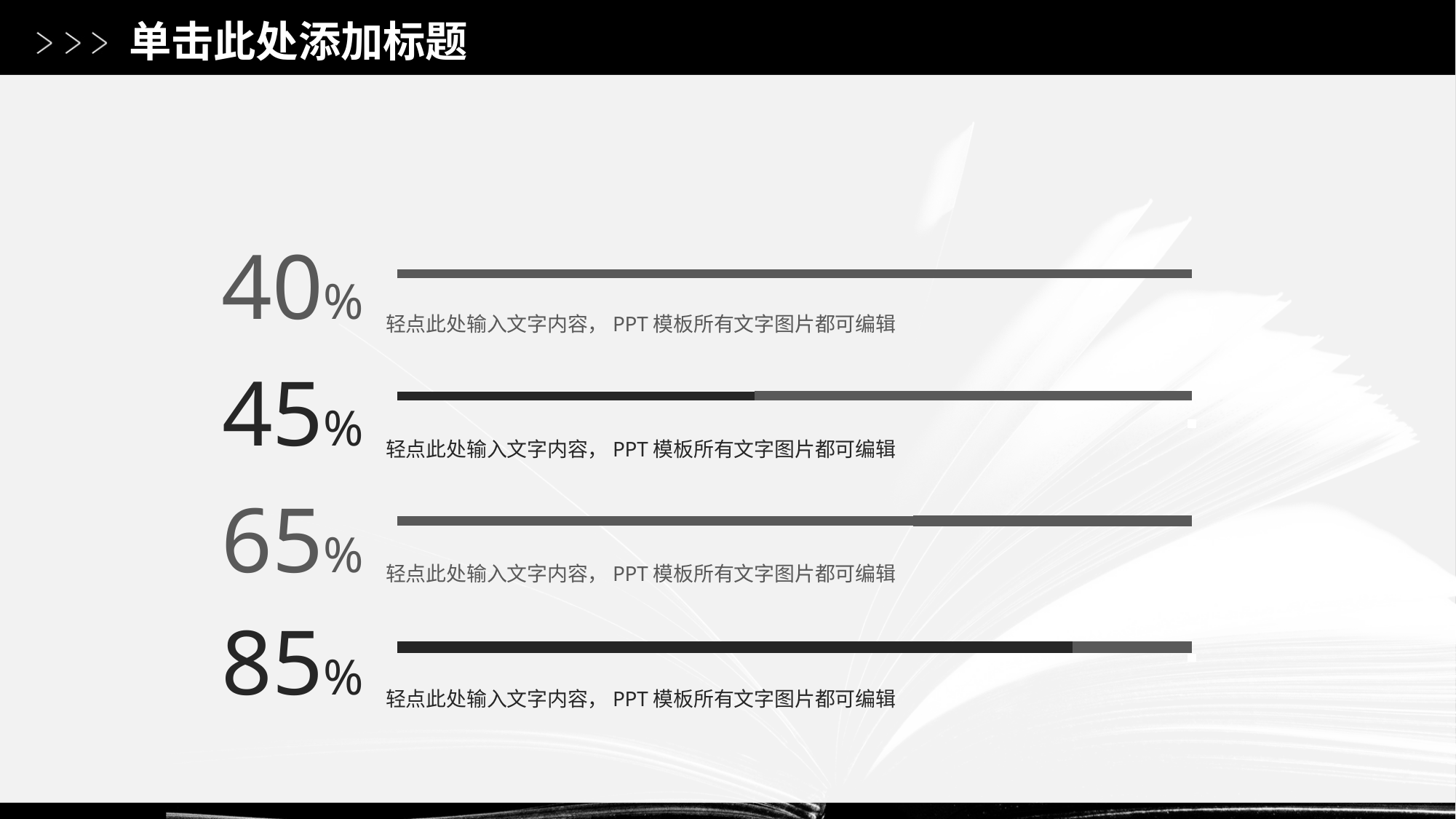
What percentage is shown for the first (top) bar? 40% What is the difference between the third bar's percentage and the second bar's percentage? 20% How many progress bars are shown on the slide? 4 What percentage is shown for the second bar from the top? 45% Which bar has the lowest percentage? The top bar (40%) Which is larger, the percentage of the second bar or the third bar? The third bar (65%) What is the difference between the bottom bar's percentage and the top bar's percentage? 45% What percentage is shown for the third bar from the top? 65% What kind of chart is shown on the slide? Horizontal progress bar chart Do the percentages increase or decrease going from the top bar to the bottom bar? Increase What percentage is shown for the bottom bar? 85% Which bar has the highest percentage? The bottom bar (85%)